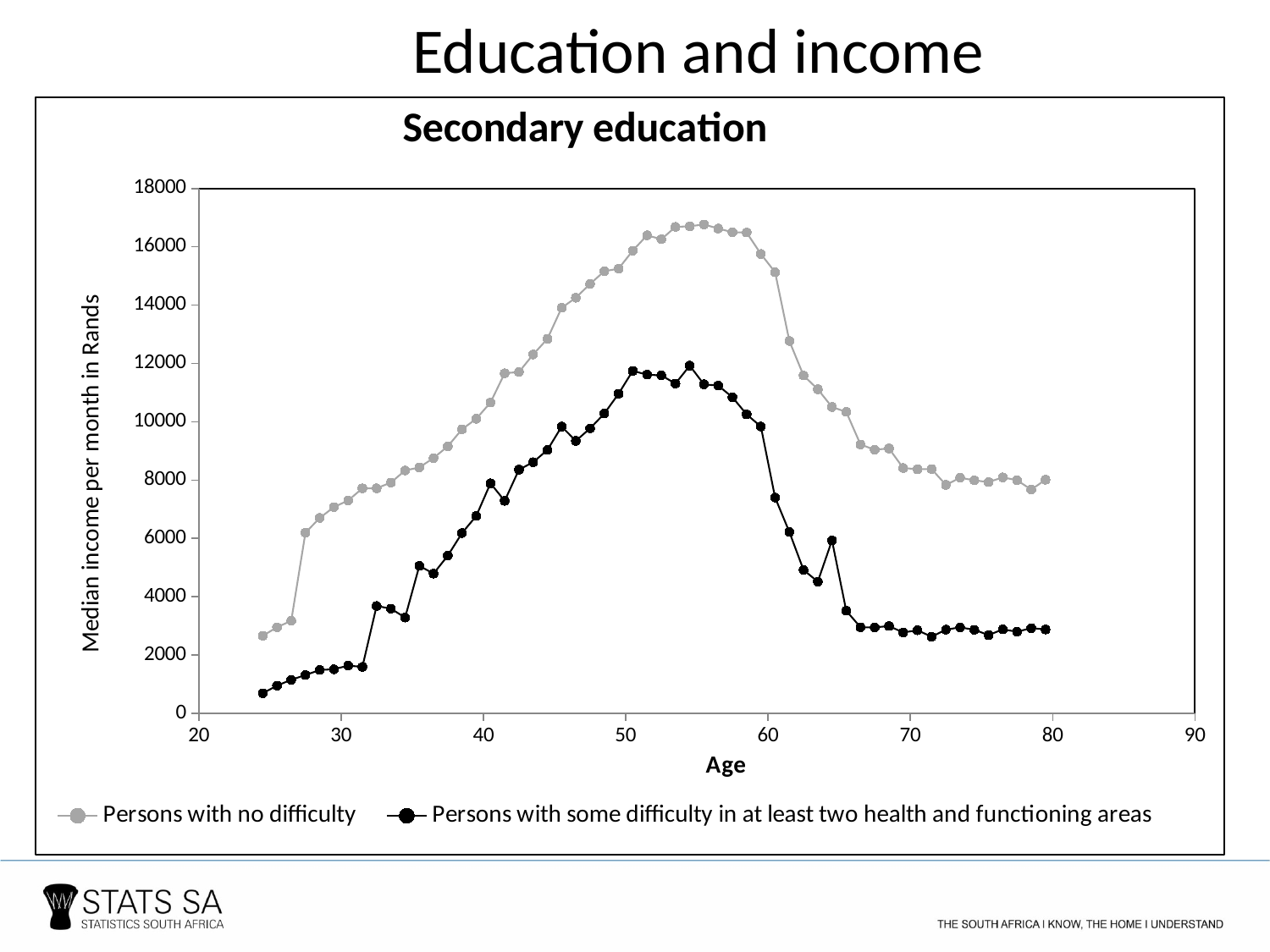
Is the value for Persons with no difficulty at age 30 greater or less than 6000? greater What is the title of the chart? Secondary education What is the label of the vertical axis? Median income per month in Rands Is the value for Persons with no difficulty at age 55 greater or less than 16000? greater At age 50, which series has the higher median income: Persons with no difficulty or Persons with some difficulty in at least two health and functioning areas? Persons with no difficulty Is the value for Persons with some difficulty in at least two health and functioning areas at age 75 greater or less than 4000? less What kind of chart is shown on the slide? line chart Between ages 60 and 67, does the value for Persons with some difficulty in at least two health and functioning areas rise or fall? fall How many series does the legend list? 2